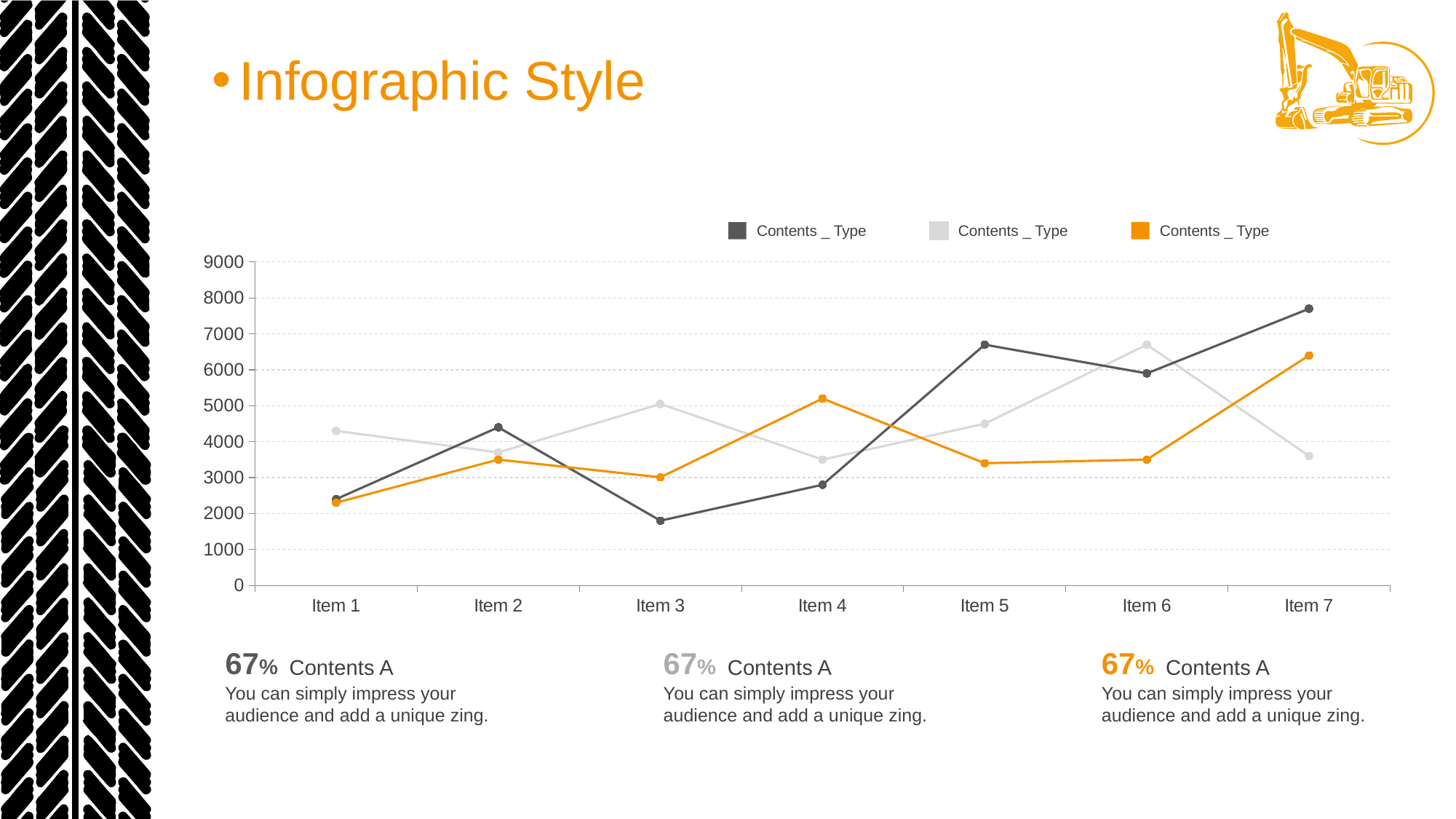
At which item does the orange line reach its highest value? Item 7 Is the value of the dark grey line at Item 7 greater or less than 7000? greater How many items are plotted along the x axis? 7 At which item does the dark grey line reach its lowest value? Item 3 Is the value of the orange line at Item 7 greater or less than 6000? greater At Item 1, which line has the higher value, the light grey line or the dark grey line? light grey line Is the value of the dark grey line at Item 3 greater or less than 3000? less Between Item 6 and Item 7, does the light grey line rise or fall? fall At which item does the dark grey line reach its highest value? Item 7 At which item does the light grey line reach its highest value? Item 6 How many series does the legend list? 3 What kind of chart is shown on the slide? line chart